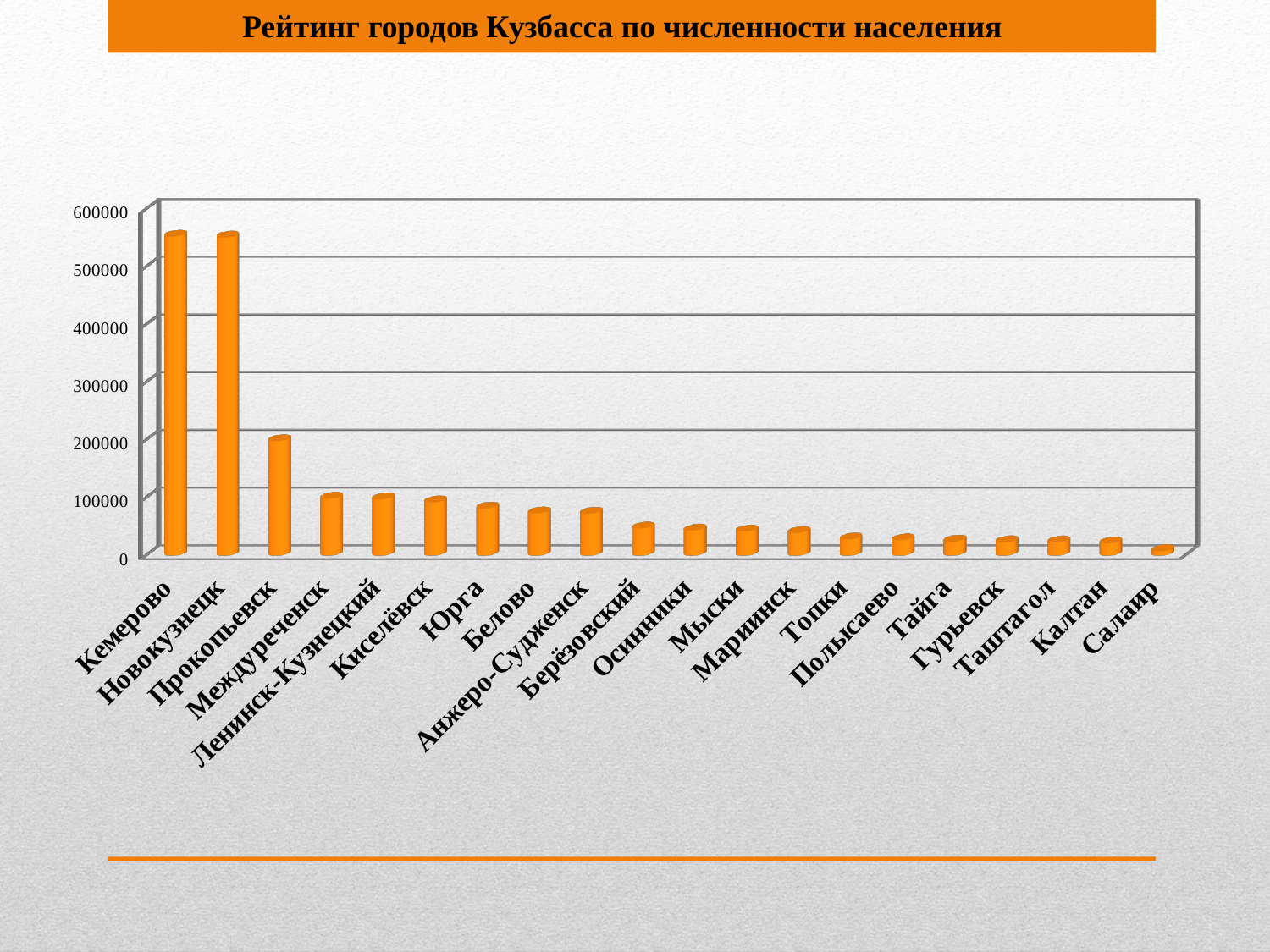
Which has a larger value, Кемерово or Прокопьевск? Кемерово Which city has the lowest value in the chart? Салаир Is the value for Мариинск greater or less than 100000? less Which has a larger value, Прокопьевск or Междуреченск? Прокопьевск Is the value for Юрга greater or less than 100000? less Is the value for Кемерово greater or less than 500000? greater How many cities are shown on the x axis of the chart? 20 What colour are the bars in the chart? orange Do the values generally rise or fall moving from left to right along the x axis? fall What kind of chart is shown on the slide? bar chart What is the title of the chart? Рейтинг городов Кузбасса по численности населения